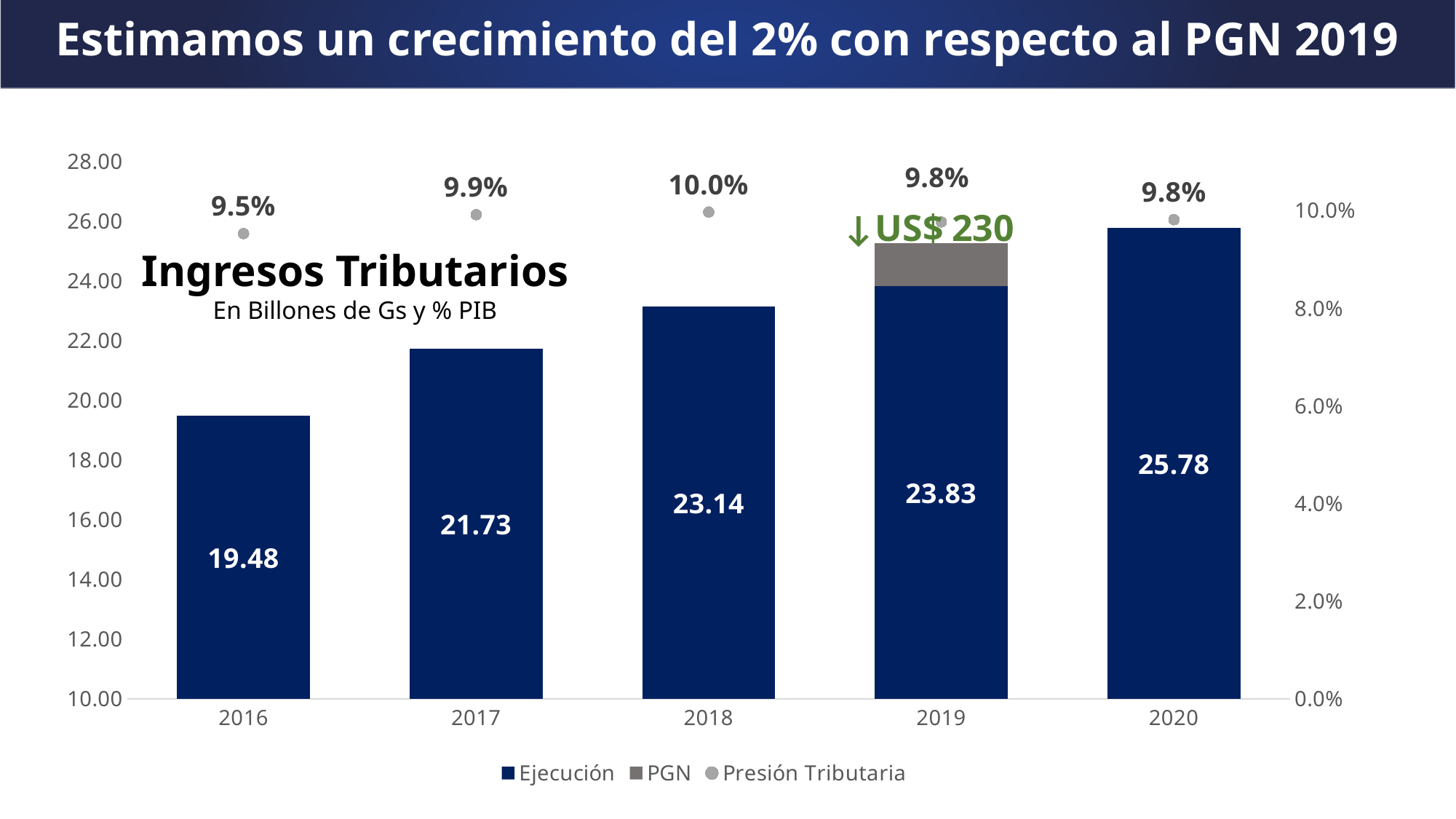
Do the Ejecución values rise or fall from 2016 to 2020? rise Which year has the lowest Ejecución value? 2016 What is the Ejecución value for 2020? 25.78 What is the Ejecución value for 2018? 23.14 Which is larger, the Ejecución value for 2017 or for 2018? 2018 Which year has the highest Presión Tributaria? 2018 How many series does the legend list? 3 How many years are shown on the x axis? 5 Is the Ejecución value for 2016 greater or less than 20.00? less What is the Ejecución value for 2016? 19.48 What is the Presión Tributaria value for 2017? 9.9% What is the difference between the Ejecución values for 2020 and 2019? 1.95